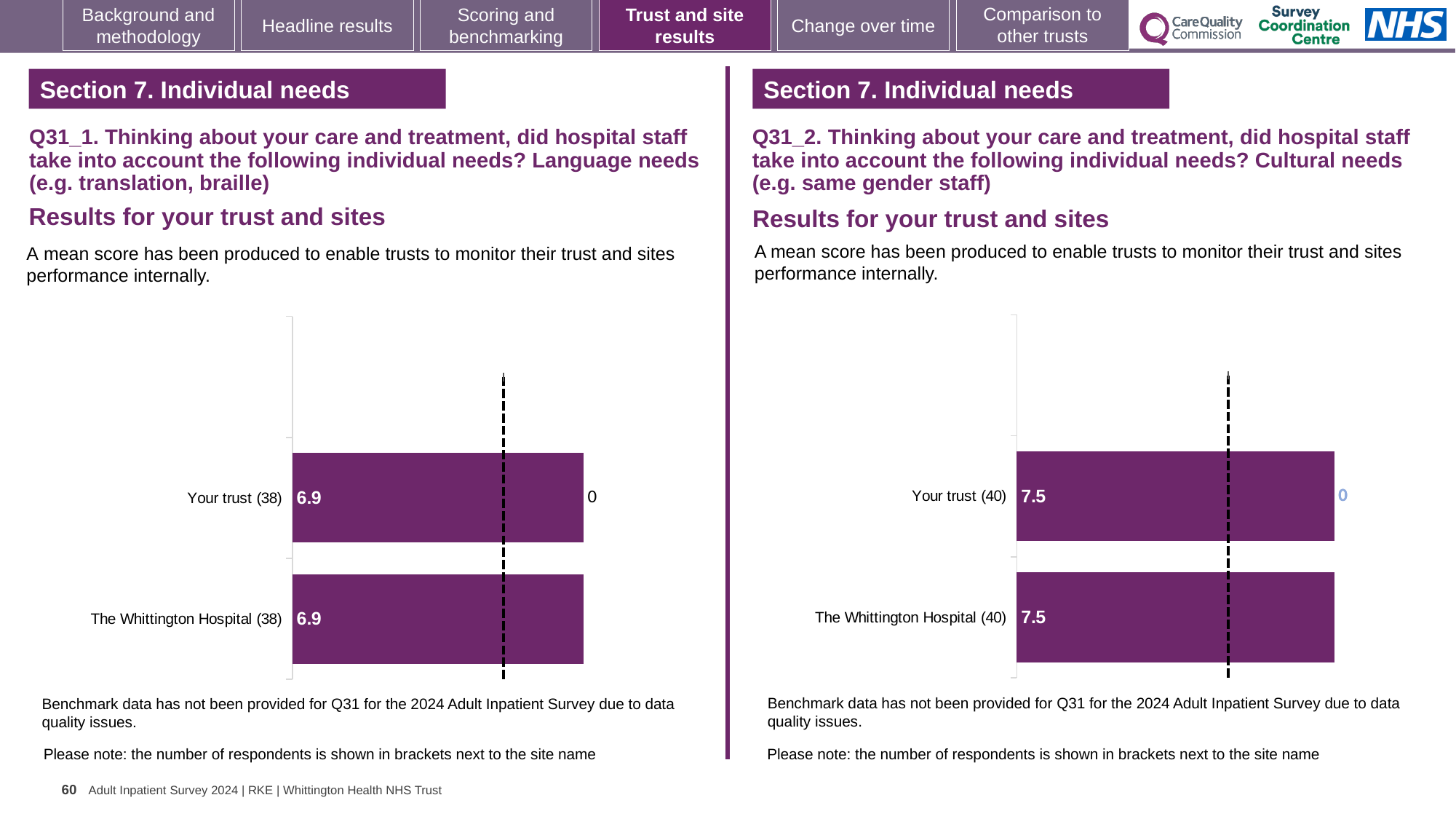
How many bars are plotted on the left chart (Q31_1, Language needs)? 2 On the right chart (Q31_2, Cultural needs), how many respondents are shown in brackets for The Whittington Hospital? 40 On the right chart (Q31_2, Cultural needs), what is the mean score for The Whittington Hospital? 7.5 On the right chart (Q31_2, Cultural needs), what is the difference between the scores for Your trust and The Whittington Hospital? 0 On the left chart (Q31_1, Language needs), what is the mean score for The Whittington Hospital? 6.9 How many bars are plotted on the right chart (Q31_2, Cultural needs)? 2 On the right chart (Q31_2, Cultural needs), what is the mean score for Your trust? 7.5 On the left chart (Q31_1, Language needs), how many respondents are shown in brackets for Your trust? 38 What type of chart is used on the left (Q31_1, Language needs)? Bar chart On the left chart (Q31_1, Language needs), what is the mean score for Your trust? 6.9 Is the Your trust score on the right chart (Q31_2, Cultural needs) larger or smaller than the Your trust score on the left chart (Q31_1, Language needs)? larger On the left chart (Q31_1, Language needs), what is the difference between the scores for Your trust and The Whittington Hospital? 0